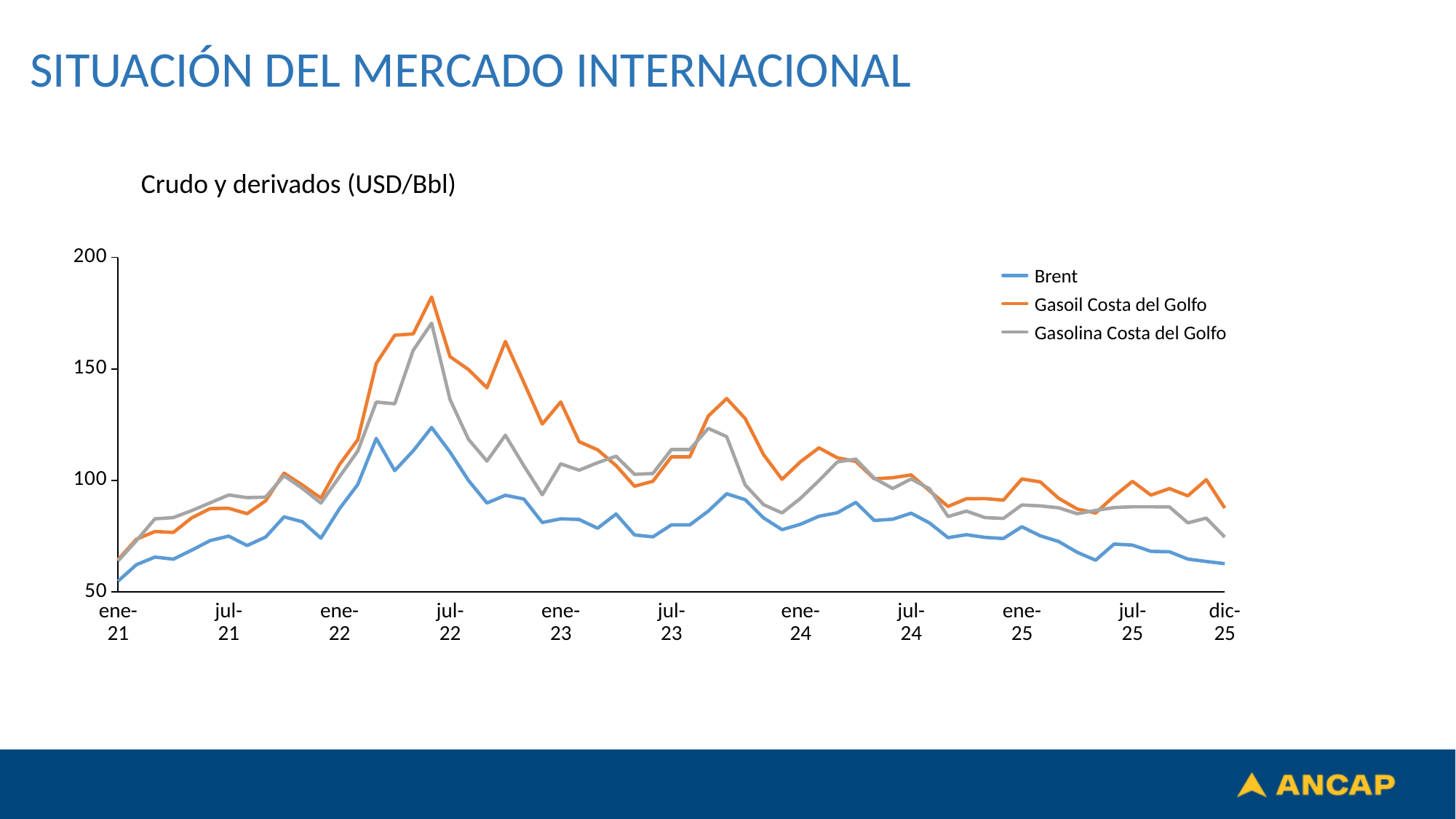
Is the peak value of Brent around jul-22 greater or less than 150? less How many series does the legend list? 3 Which series has the lowest values across the whole period? Brent Is the value for Brent at ene-21 greater or less than 100? less Does the Brent series rise or fall between jul-22 and ene-23? fall At dic-25, which is higher: Brent or Gasoil Costa del Golfo? Gasoil Costa del Golfo Is the value for Gasolina Costa del Golfo at dic-25 greater or less than 100? less Which series is drawn in orange? Gasoil Costa del Golfo Which series reaches the highest value on the chart? Gasoil Costa del Golfo What kind of chart is shown on the slide? line chart What is the title of the chart? Crudo y derivados (USD/Bbl)